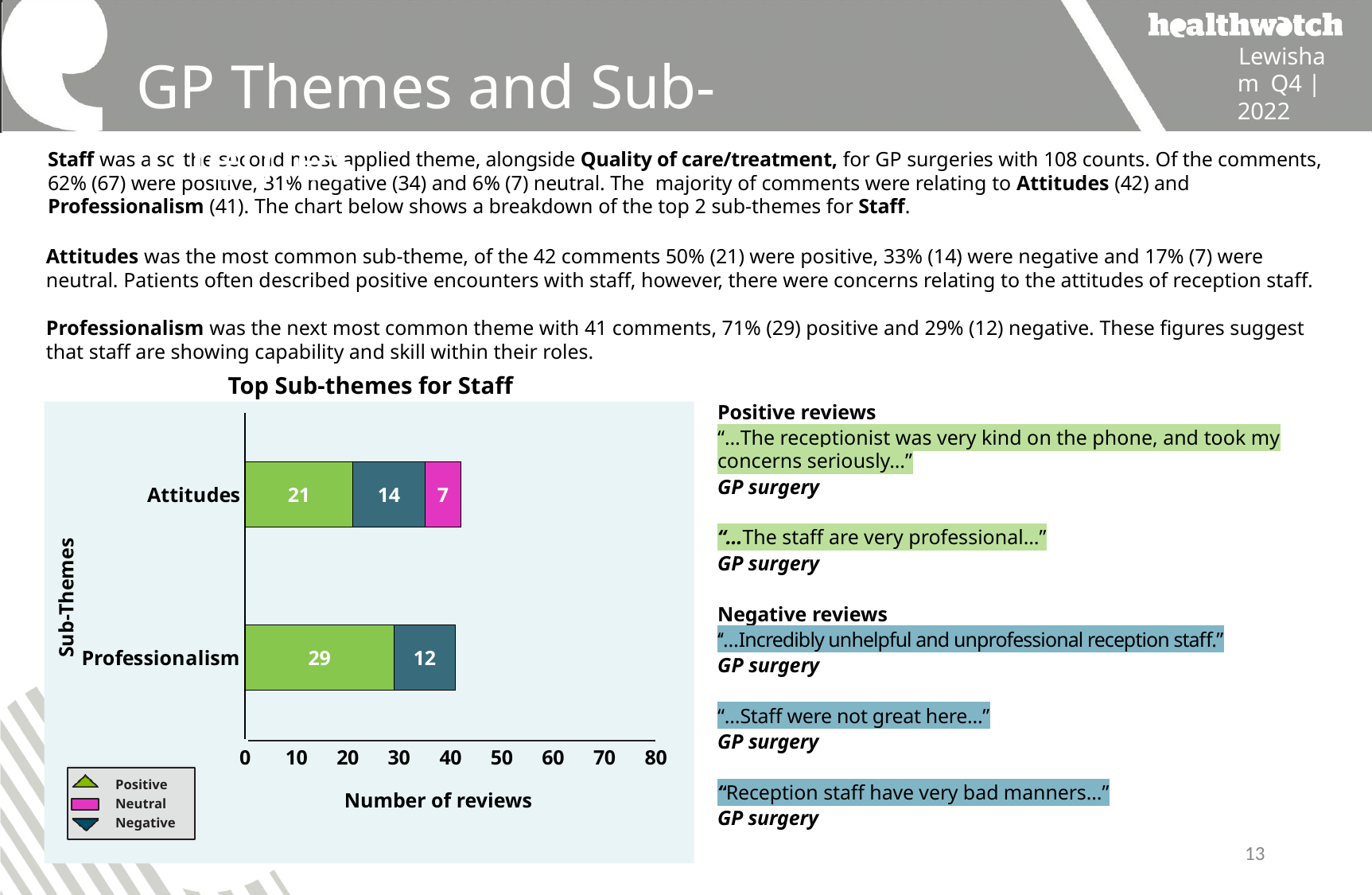
What is the total number of reviews in the Professionalism bar? 41 How many negative reviews are shown for Professionalism? 12 What is the total number of reviews in the Attitudes bar? 42 What is the label of the horizontal axis of the chart? Number of reviews Which sub-theme has the higher number of positive reviews? Professionalism How many positive reviews are shown for Attitudes? 21 How many sub-themes are plotted in the chart? 2 How many series does the chart legend list? 3 How many neutral reviews are shown for Attitudes? 7 What type of chart is shown under the title 'Top Sub-themes for Staff'? Stacked bar chart How many positive reviews are shown for Professionalism? 29 What is the difference between the positive reviews for Professionalism and the positive reviews for Attitudes? 8